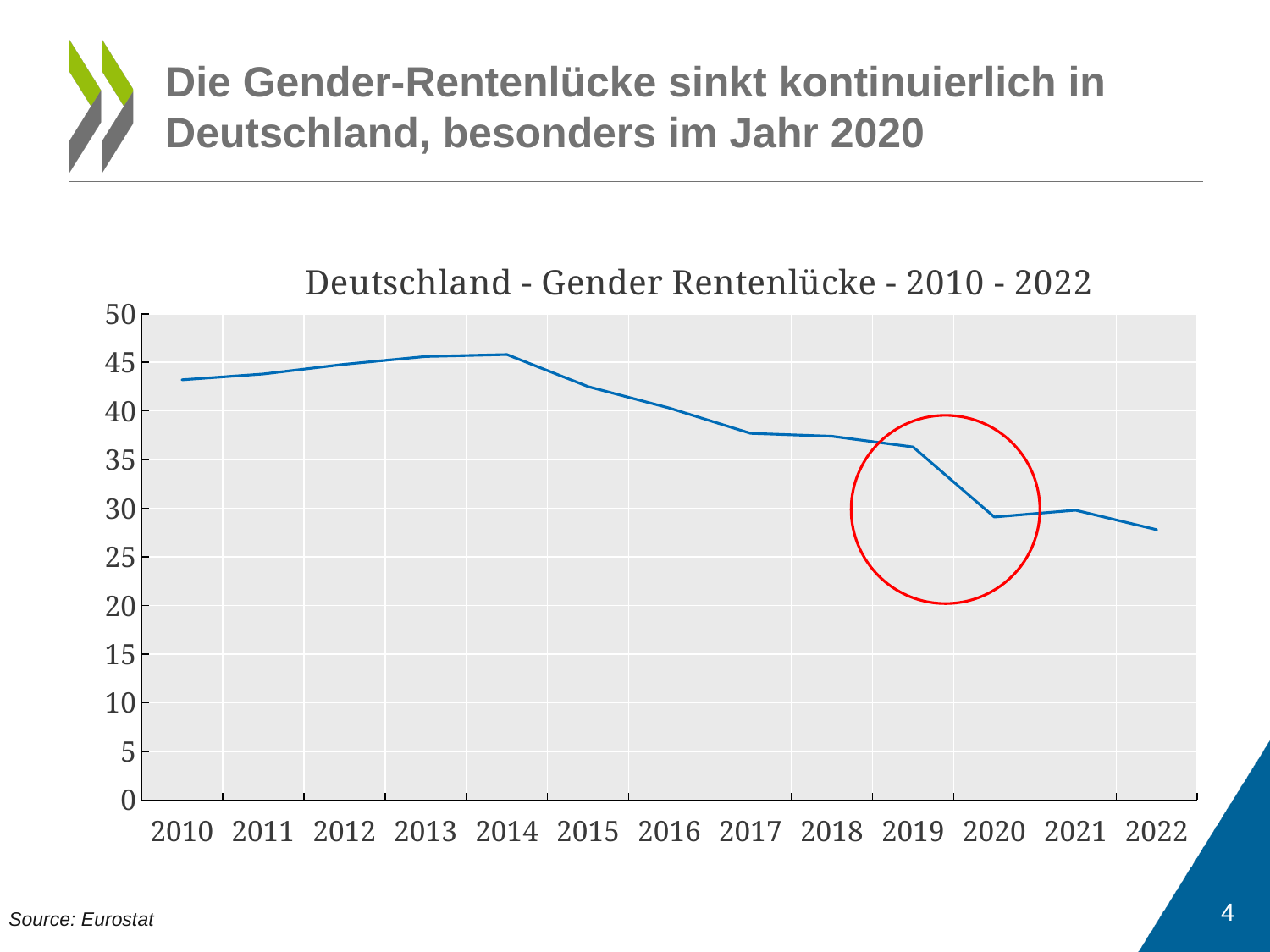
Is the value for 2017 greater or less than 40? less Which year has the larger value, 2010 or 2020? 2010 Which year has the larger value, 2019 or 2020? 2019 What kind of chart is shown on the slide? line chart What is the title of the chart? Deutschland - Gender Rentenlücke - 2010 - 2022 Is the value for 2020 greater or less than 35? less Is the value for 2022 greater or less than 30? less Overall, do the values rise or fall from 2010 to 2022? fall How many years are plotted on the x axis of the chart? 13 Which year is highlighted by the red circle on the chart? 2020